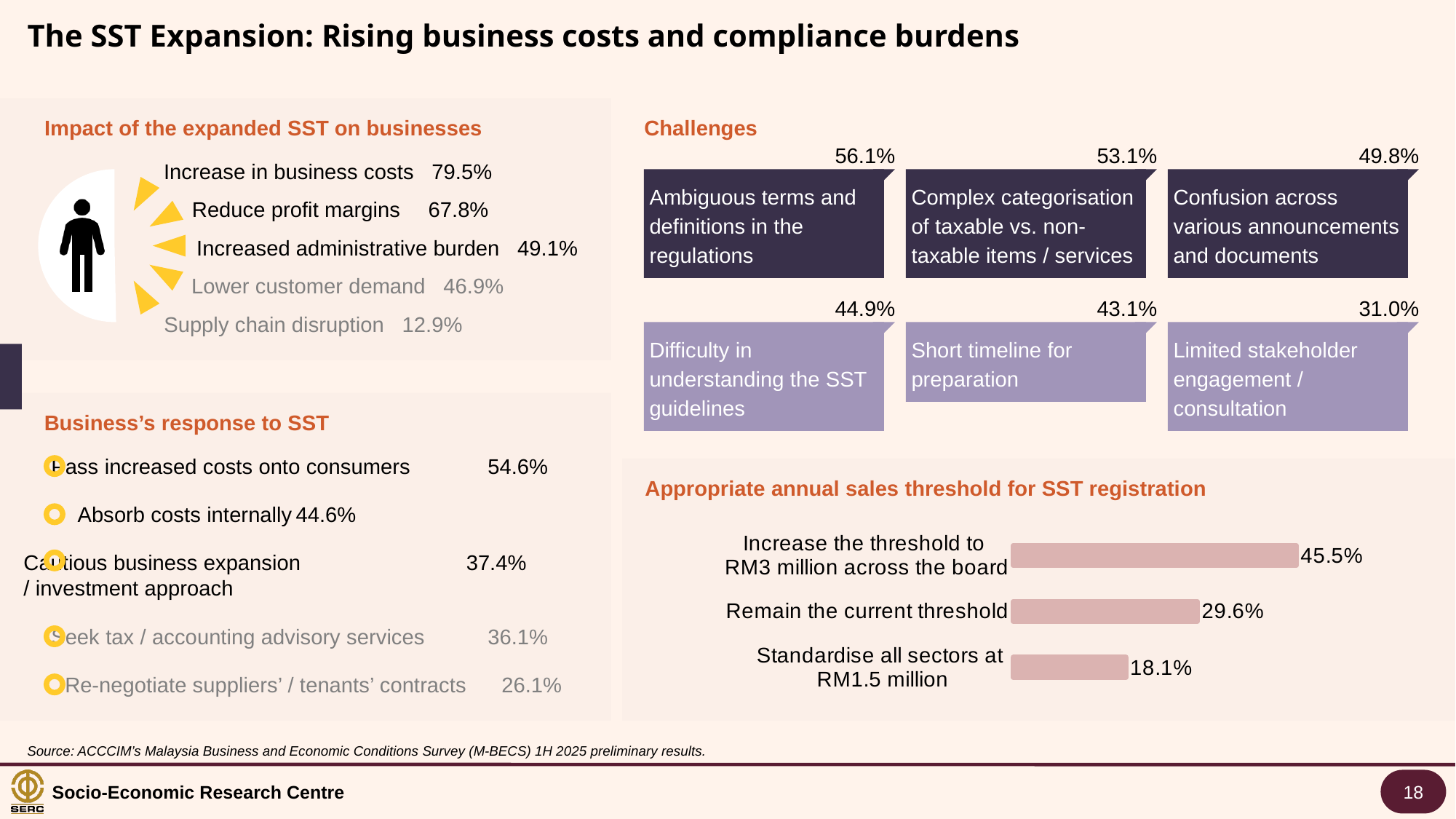
In the 'Appropriate annual sales threshold for SST registration' chart, what is the value for 'Increase the threshold to RM3 million across the board'? 45.5% How many categories are shown in the 'Appropriate annual sales threshold for SST registration' chart? 3 What kind of chart is the 'Appropriate annual sales threshold for SST registration' chart? Bar chart What is the title of the bar chart in the lower right of the slide? Appropriate annual sales threshold for SST registration In the 'Appropriate annual sales threshold for SST registration' chart, what is the value for 'Standardise all sectors at RM1.5 million'? 18.1% In the 'Appropriate annual sales threshold for SST registration' chart, which is larger: 'Remain the current threshold' or 'Standardise all sectors at RM1.5 million'? Remain the current threshold In the 'Appropriate annual sales threshold for SST registration' chart, are the bars drawn horizontally or vertically? Horizontally In the 'Appropriate annual sales threshold for SST registration' chart, which option has the highest value? Increase the threshold to RM3 million across the board In the 'Appropriate annual sales threshold for SST registration' chart, what is the value for 'Remain the current threshold'? 29.6% In the 'Appropriate annual sales threshold for SST registration' chart, what is the difference between 'Increase the threshold to RM3 million across the board' and 'Remain the current threshold'? 15.9% In the 'Appropriate annual sales threshold for SST registration' chart, what is the difference between 'Remain the current threshold' and 'Standardise all sectors at RM1.5 million'? 11.5% In the 'Appropriate annual sales threshold for SST registration' chart, which option has the lowest value? Standardise all sectors at RM1.5 million